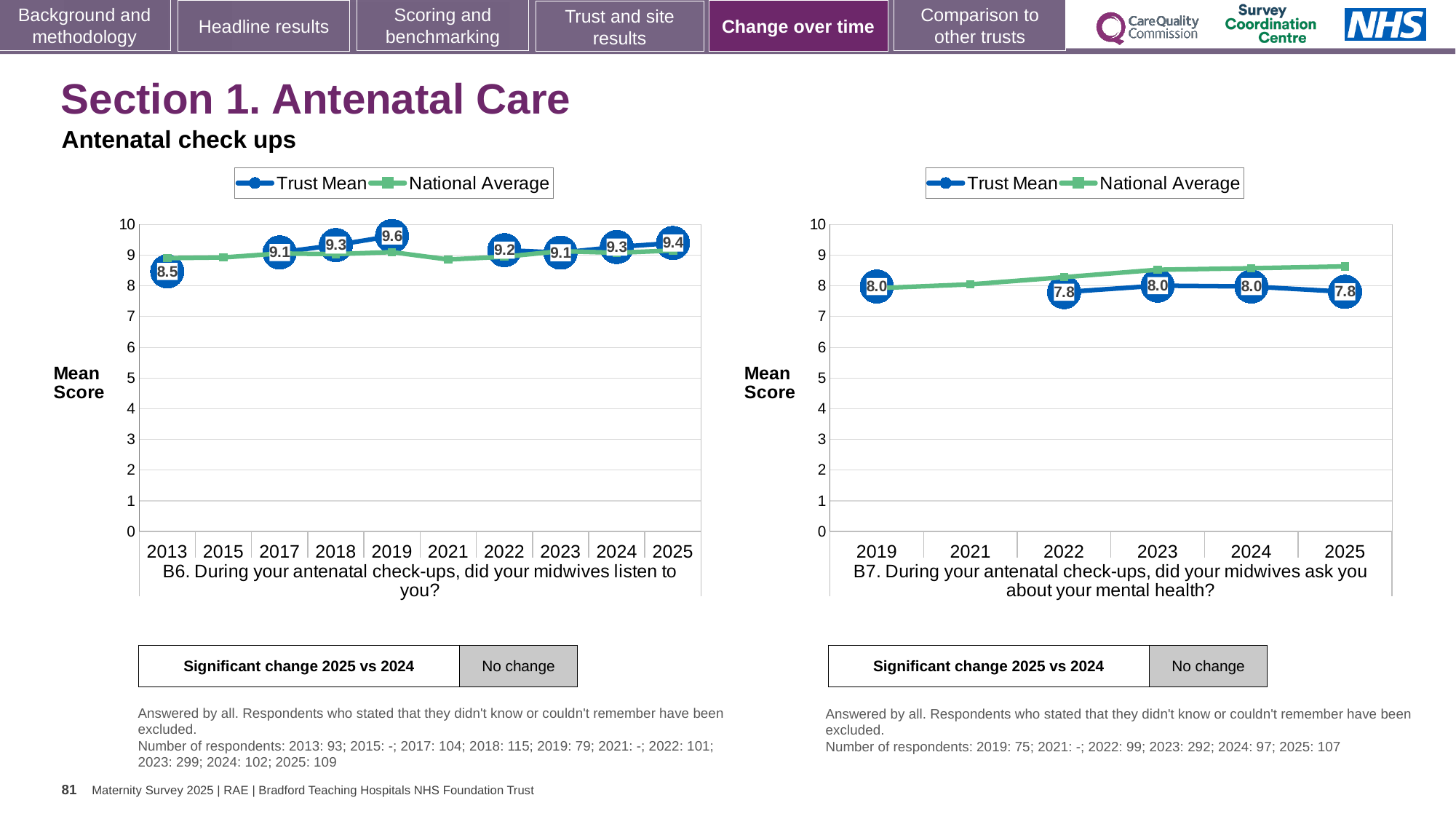
How many years are shown on the x axis of the B7 chart on the right? 6 In the B6 chart on the left, which year has the lowest Trust Mean? 2013 What type of chart is the B7 chart on the right? Line chart In the B6 chart on the left, what is the Trust Mean for 2019? 9.6 In the B6 chart on the left, what is the difference between the Trust Mean in 2019 and in 2013? 1.1 In the B7 chart on the right, what is the Trust Mean for 2025? 7.8 In the B7 chart on the right, is the National Average for 2025 greater or less than 8? greater In the B7 chart on the right, what is the difference between the Trust Mean in 2023 and in 2025? 0.2 In the B6 chart on the left, is the Trust Mean higher in 2025 or in 2023? 2025 How many series does the legend of the B6 chart on the left list? 2 In the B6 chart on the left, what is the Trust Mean for 2013? 8.5 In the B6 chart on the left, which year has the highest Trust Mean? 2019